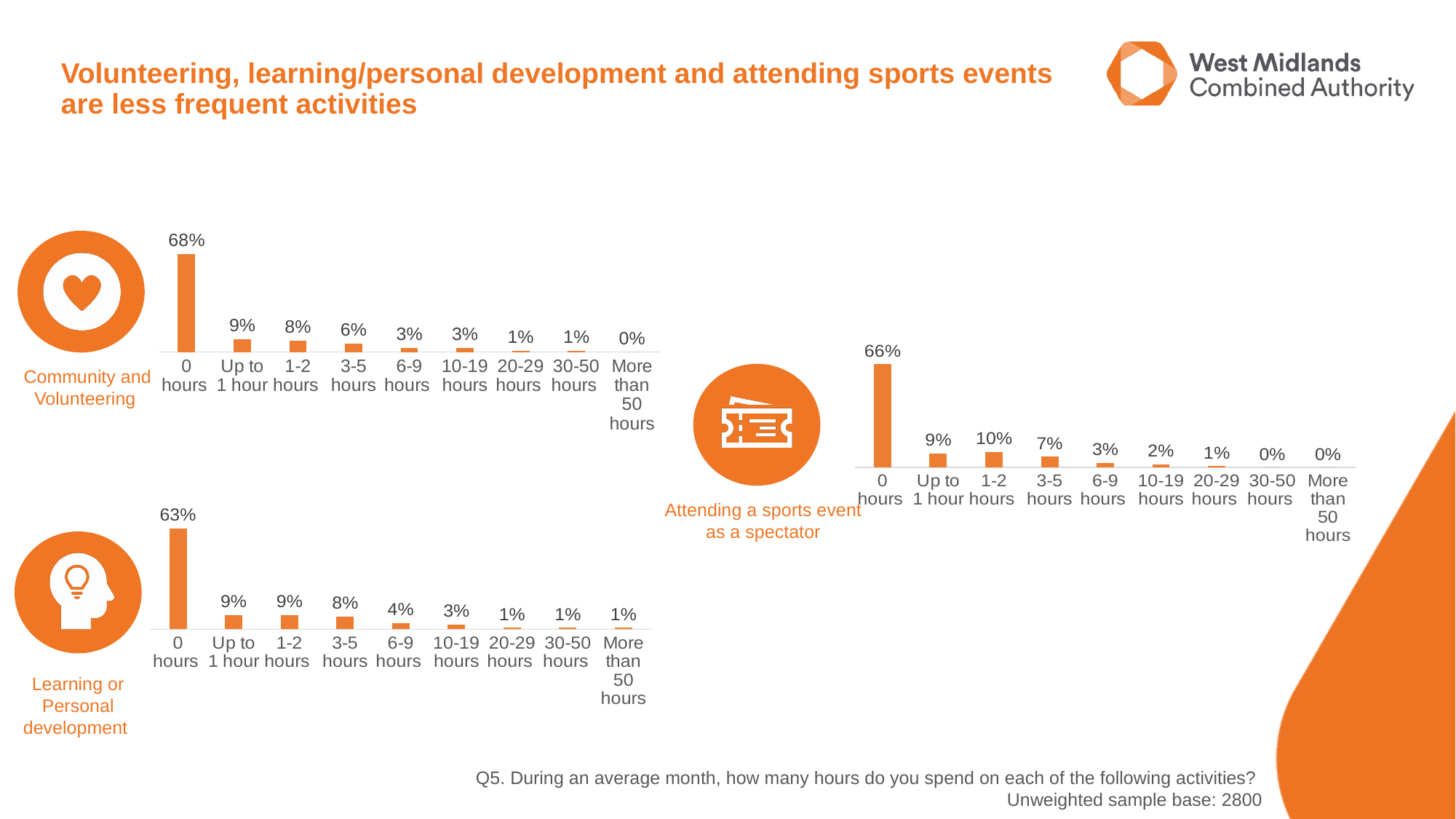
In the Learning or Personal development chart, what is the value for 3-5 hours? 8% In the Attending a sports event as a spectator chart, what is the value for 1-2 hours? 10% How many categories are shown on the x axis of the Learning or Personal development chart? 9 In the Learning or Personal development chart, which is larger: the value for 6-9 hours or the value for 10-19 hours? 6-9 hours In the Community and Volunteering chart, what is the value for 0 hours? 68% What kind of chart is the Community and Volunteering chart? Bar chart In the Attending a sports event as a spectator chart, do the values generally rise or fall from 1-2 hours to More than 50 hours? Fall In the Attending a sports event as a spectator chart, which category has the highest value? 0 hours How many charts are shown on the slide? 3 In the Learning or Personal development chart, what is the difference between the values for 0 hours and 1-2 hours? 54% In the Community and Volunteering chart, what is the difference between the values for 0 hours and Up to 1 hour? 59% In the Attending a sports event as a spectator chart, what is the value for 30-50 hours? 0%